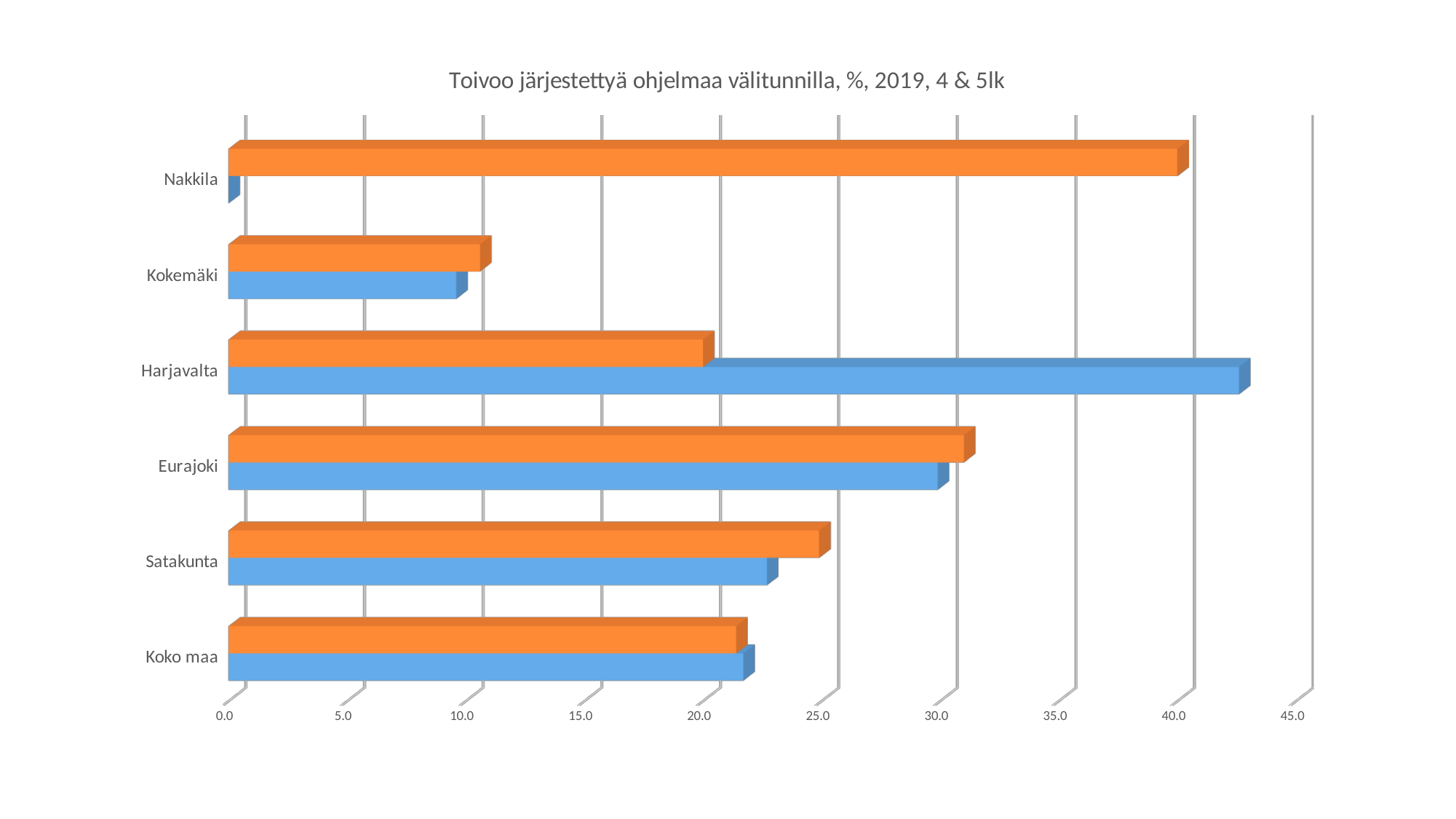
What is the title of the chart? Toivoo järjestettyä ohjelmaa välitunnilla, %, 2019, 4 & 5lk What two colours are used for the bars in the chart? orange and blue How many categories are shown on the vertical axis of the chart? 6 Which category has the shortest orange bar? Kokemäki Is the orange bar for Nakkila greater or less than 35.0? greater Is the blue bar for Nakkila greater or less than 5.0? less Which category has the longest orange bar? Nakkila For Harjavalta, which bar is longer, the orange one or the blue one? the blue one Which category has the shortest blue bar? Nakkila Is the blue bar for Harjavalta greater or less than 40.0? greater Which category has the longest blue bar? Harjavalta What kind of chart is shown on the slide? bar chart